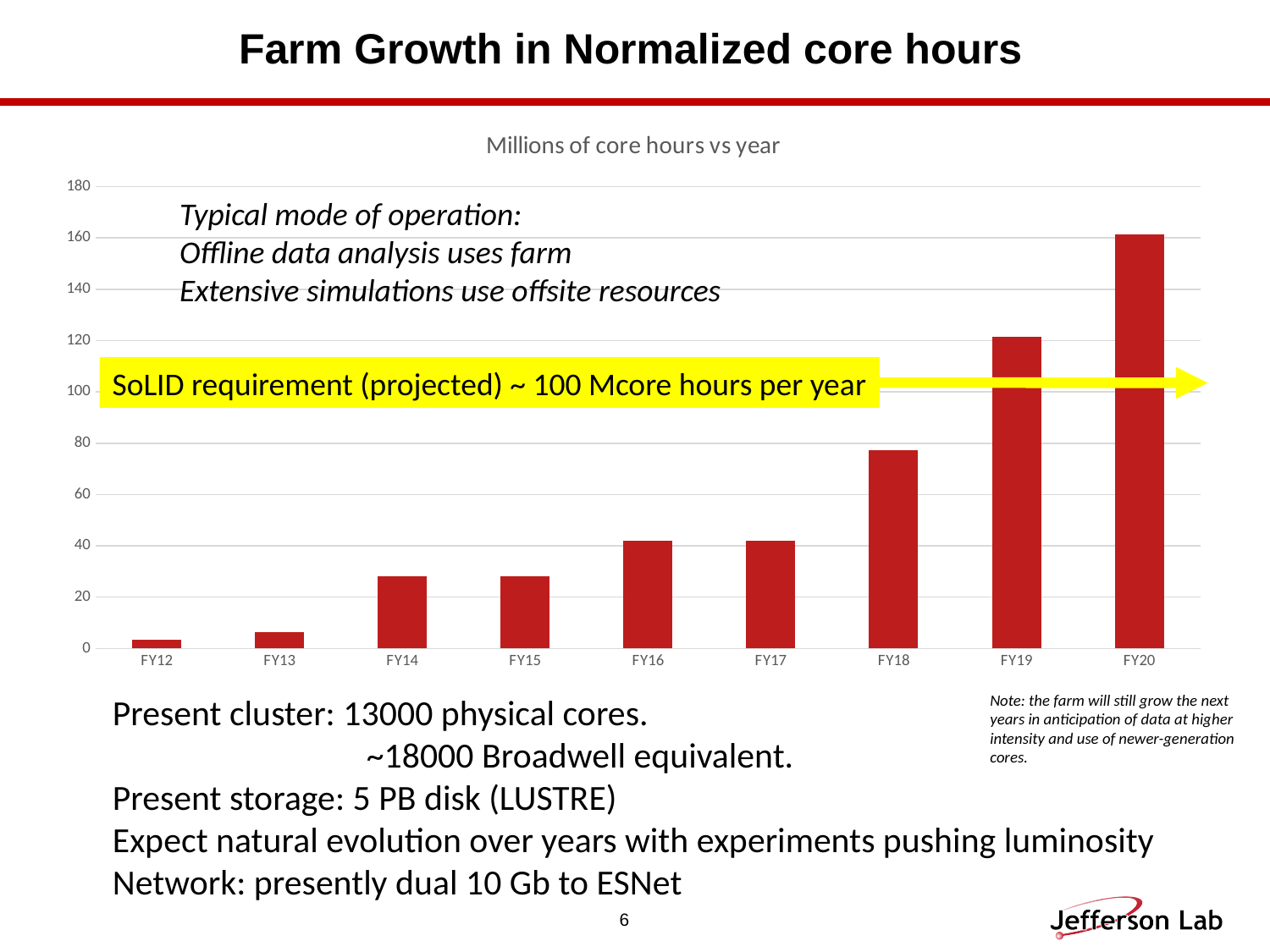
How many fiscal years are plotted on the x axis? 9 What is the title of the chart? Millions of core hours vs year Which fiscal year has the highest value? FY20 Is the value for FY20 greater or less than 160? greater Which is larger, the value for FY18 or the value for FY17? FY18 What kind of chart is shown on the slide? bar chart Is the value for FY19 greater or less than 100? greater Is the value for FY16 greater or less than 40? greater Do the values generally rise or fall from FY12 to FY20? rise Which fiscal year has the lowest value? FY12